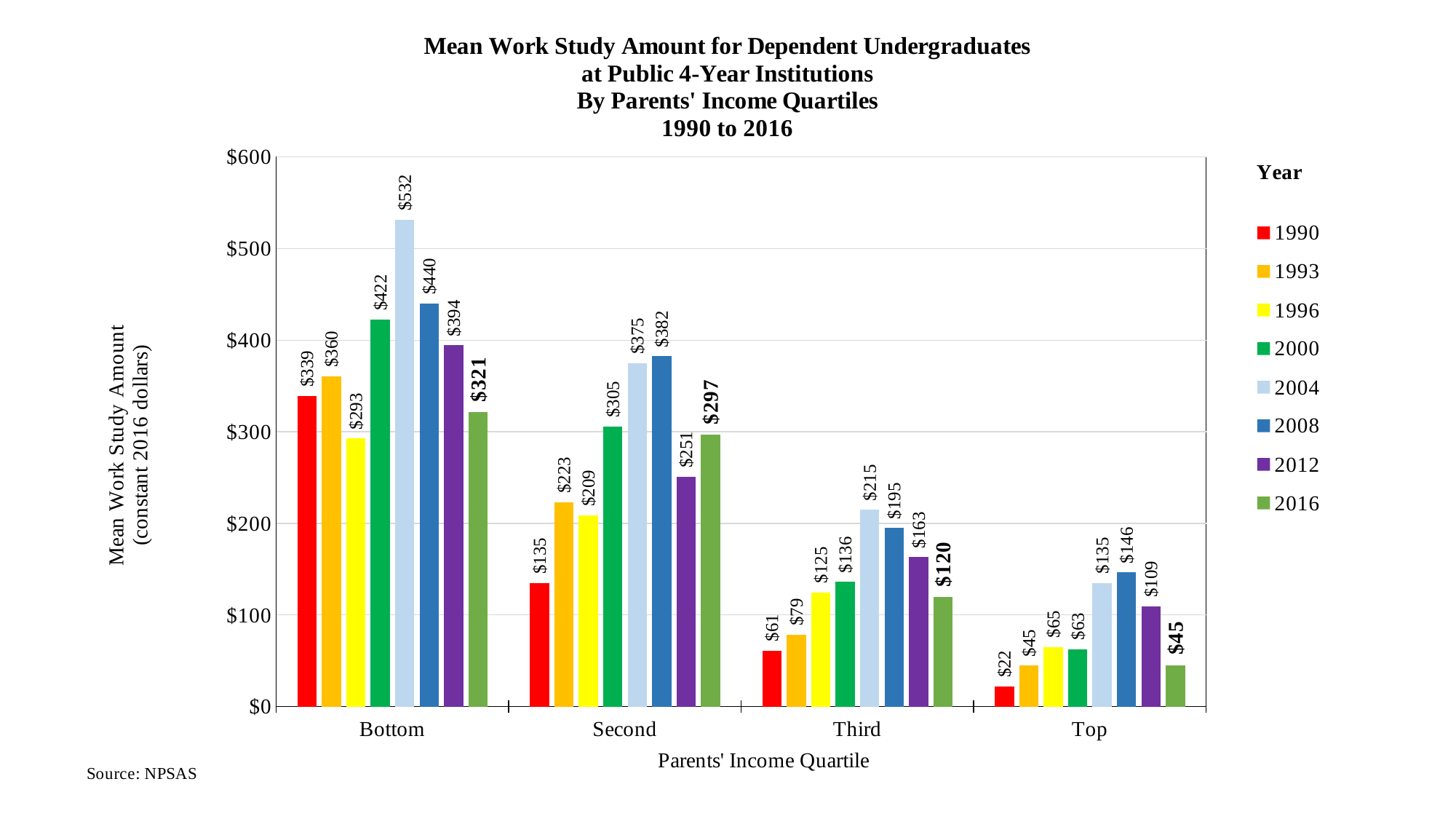
Which year has the lowest mean work study amount for the Top quartile? 1990 How many years does the legend list? 8 Which is larger for the Second quartile: the 2008 value or the 2012 value? 2008 What is the mean work study amount for the Second quartile in 1990? $135 What is the source cited for the chart? NPSAS Is the 2000 value for the Bottom quartile greater or less than $400? greater Which year has the highest mean work study amount for the Third quartile? 2004 How many income quartile categories are shown on the x axis? 4 What is the difference between the 2004 and 2016 values for the Bottom quartile? $211 What is the mean work study amount for the Top quartile in 2016? $45 What kind of chart is shown on the slide? bar chart What is the mean work study amount for the Bottom quartile in 2004? $532